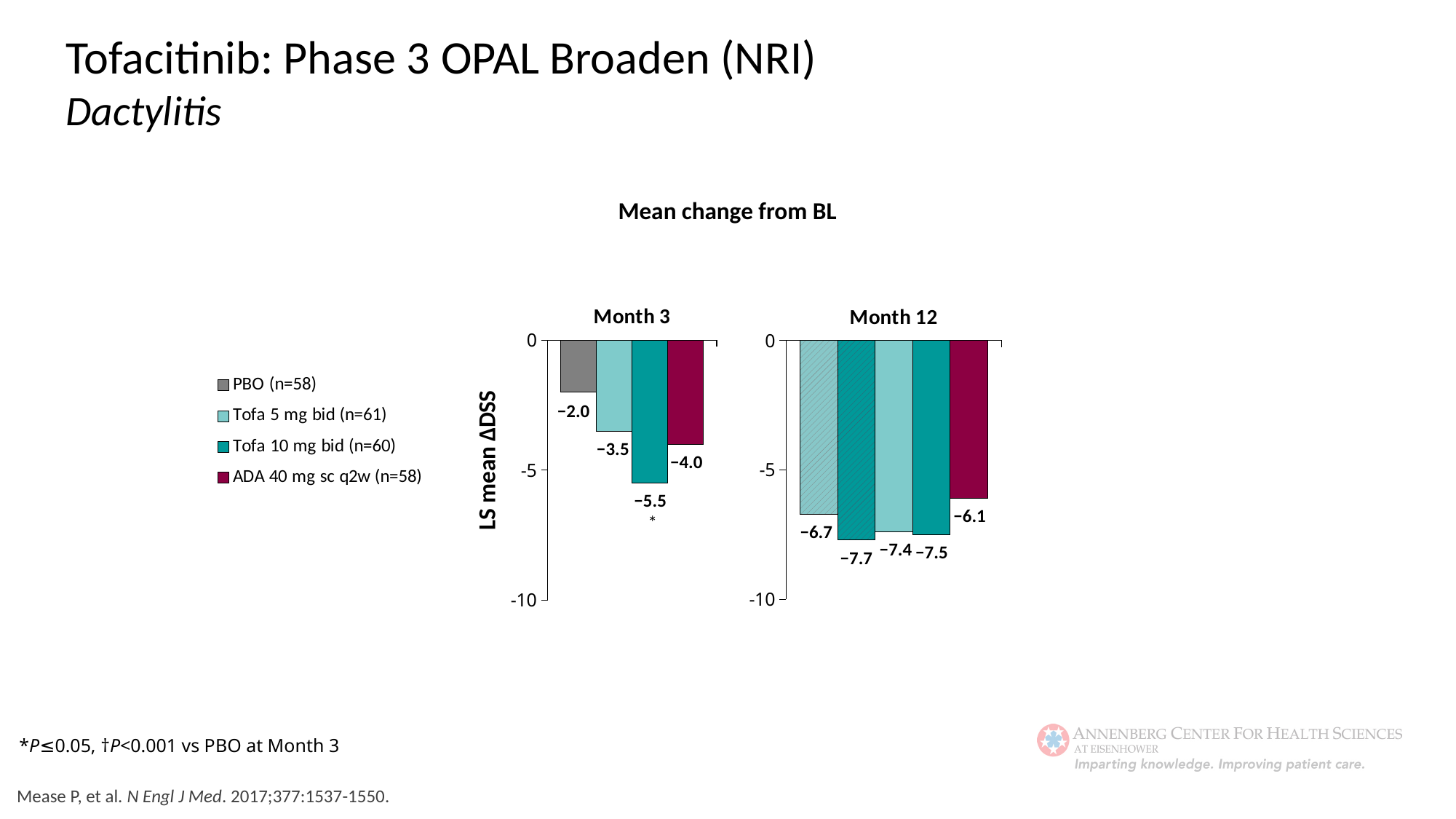
In the Month 3 chart, which has a larger reduction from baseline: Tofa 5 mg bid or ADA 40 mg sc q2w? ADA 40 mg sc q2w How many treatment groups does the legend list? 4 How many bars are shown in the Month 12 chart? 5 In the Month 3 chart, which treatment group shows the smallest change from baseline? PBO (n=58) In the Month 3 chart, what is the LS mean change in DSS for PBO (n=58)? −2.0 In the Month 12 chart, what is the value for ADA 40 mg sc q2w (n=58)? −6.1 In the Month 12 chart, what is the value labelled on the leftmost (hatched) bar? −6.7 In the Month 3 chart, what is the difference between the Tofa 10 mg bid value and the PBO value? 3.5 In the Month 3 chart, what is the value for Tofa 5 mg bid (n=61)? −3.5 In the Month 3 chart, what is the value for ADA 40 mg sc q2w (n=58)? −4.0 In the Month 3 chart, what is the value for Tofa 10 mg bid (n=60)? −5.5 In the Month 3 chart, which treatment group shows the largest reduction (most negative value)? Tofa 10 mg bid (n=60)